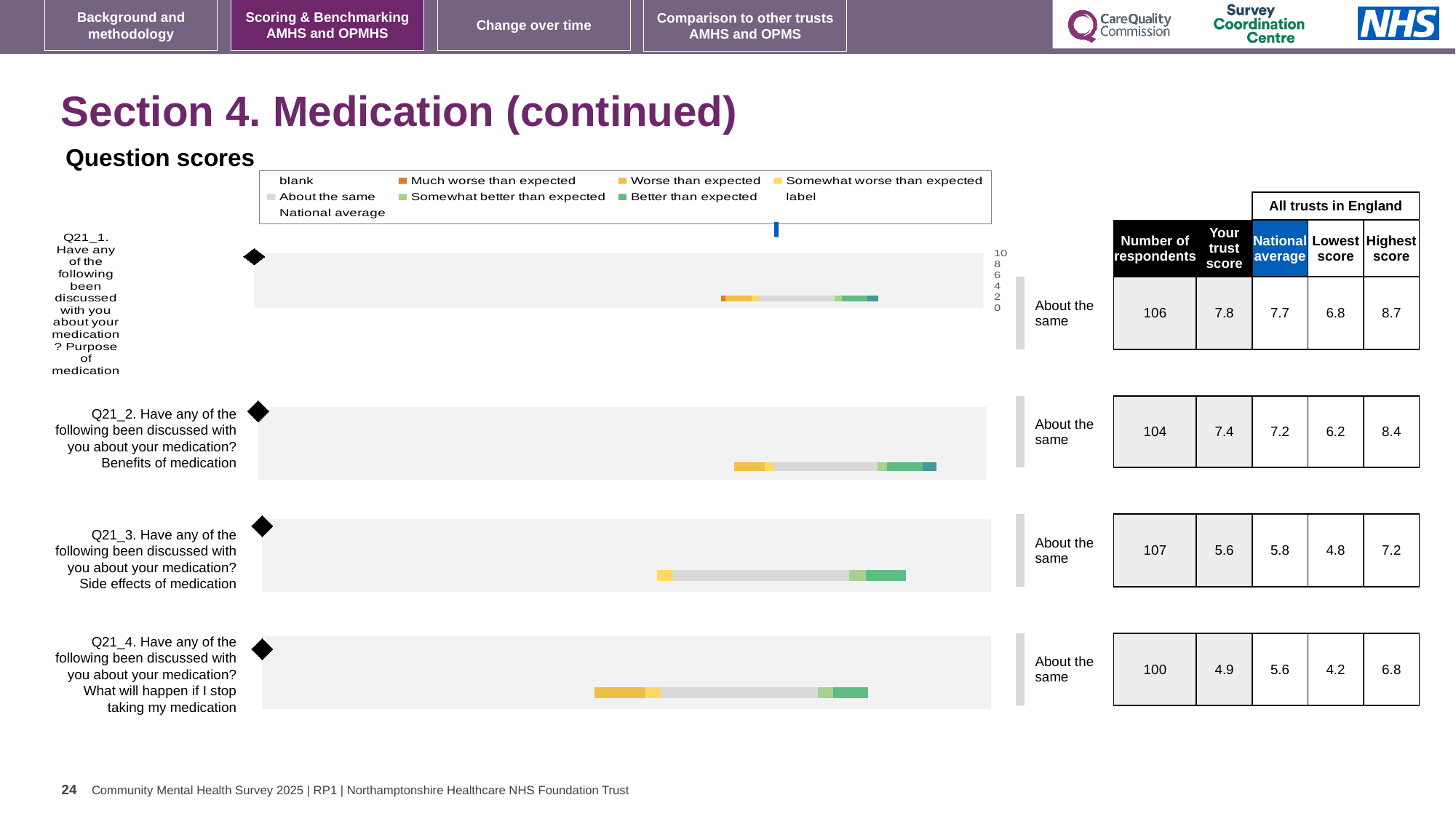
Which question has the highest trust score? Q21_1 (Purpose of medication) For Q21_1 (Purpose of medication), how much higher is the trust score than the national average? 0.1 For Q21_2 (Benefits of medication), what is the difference between the highest score and the lowest score across all trusts in England? 2.2 For Q21_3 (Side effects of medication), which is larger: the trust score or the national average? national average What kind of chart is used to show the question scores on this slide? bar chart What benchmark label is shown for Q21_2 (Benefits of medication)? About the same What is the national average for Q21_4 (What will happen if I stop taking my medication)? 5.6 Which question has the lowest trust score? Q21_4 (What will happen if I stop taking my medication) What is the trust score for Q21_1 (Purpose of medication)? 7.8 How many respondents answered Q21_3 (Side effects of medication)? 107 How many questions (Q21_1 to Q21_4) are plotted on the slide? 4 What is the lowest score across all trusts in England for Q21_2 (Benefits of medication)? 6.2